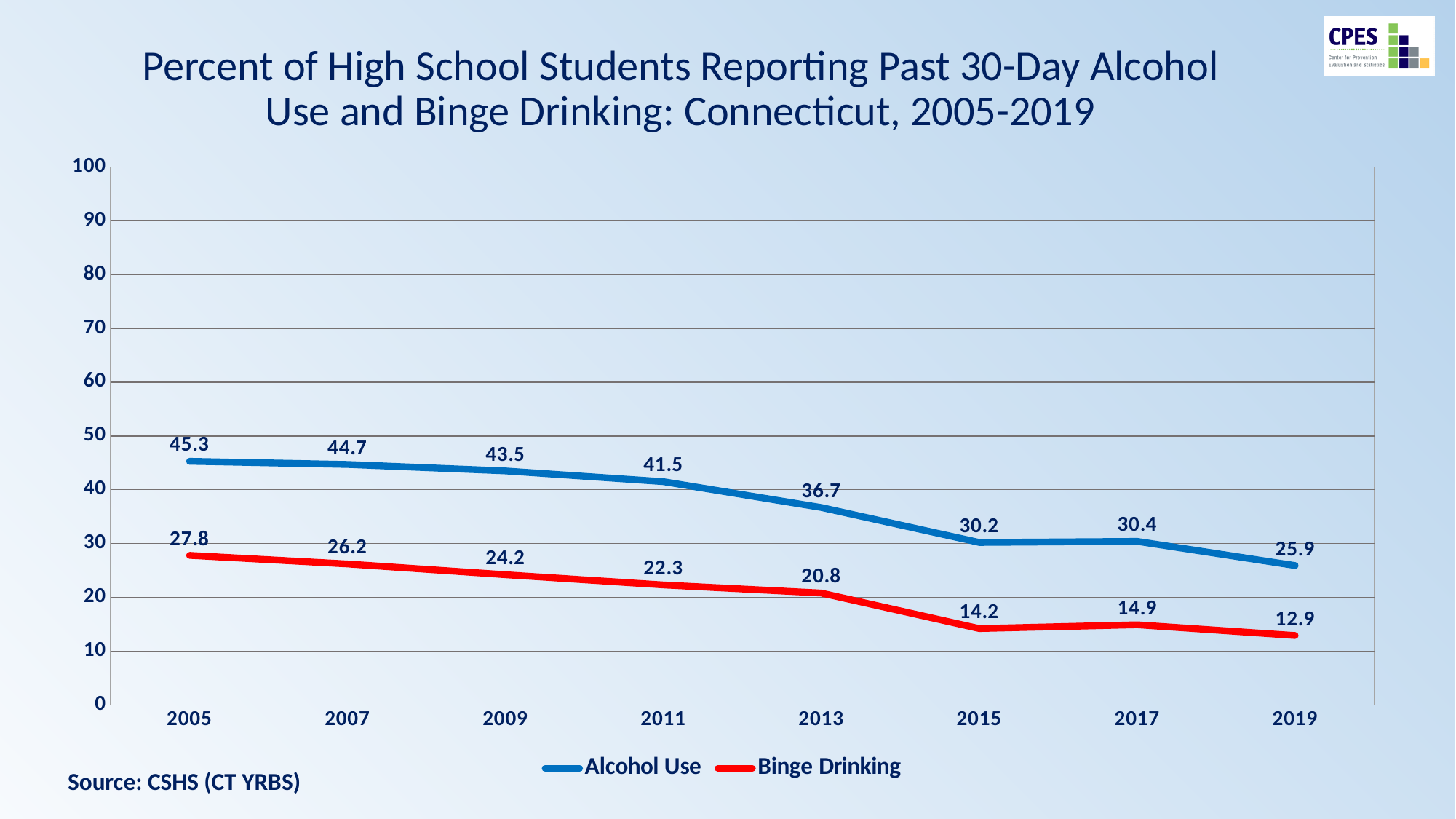
What kind of chart is this? Line chart What colour is the Binge Drinking line? Red Does Alcohol Use generally rise or fall from 2005 to 2019? Fall How many years are plotted on the x axis? 8 What is the difference between Alcohol Use and Binge Drinking in 2011? 19.2 How many series does the legend list? 2 In which year was Alcohol Use highest? 2005 Which is larger: Binge Drinking in 2015 or Binge Drinking in 2017? Binge Drinking in 2017 What was the Alcohol Use value in 2005? 45.3 What was the Binge Drinking value in 2013? 20.8 In which year was Binge Drinking lowest? 2019 What was the Alcohol Use value in 2019? 25.9